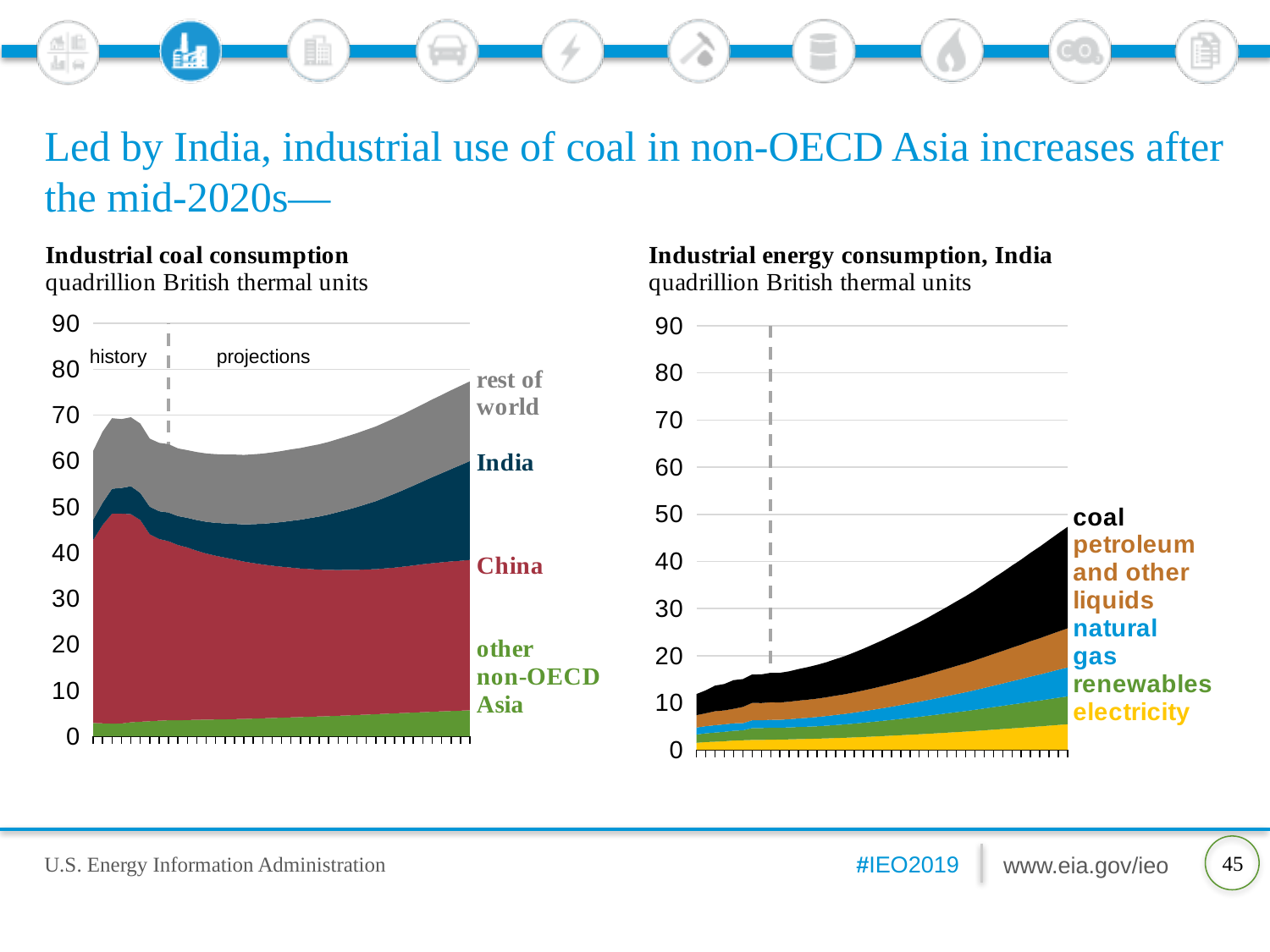
In the 'Industrial energy consumption, India' chart, does total industrial energy consumption rise or fall over the projection period? rise How many series are shown in the 'Industrial coal consumption' chart? 4 In the 'Industrial energy consumption, India' chart, is the total at the start of the history period greater or less than 20? less Which series in the 'Industrial energy consumption, India' chart is shown in yellow? electricity What unit is used on the y axis of the 'Industrial coal consumption' chart? quadrillion British thermal units In the 'Industrial energy consumption, India' chart, is the total at the end of the projection period greater or less than 40? greater What kind of chart is the 'Industrial coal consumption' chart? stacked area chart In the 'Industrial energy consumption, India' chart, is the total at the end of the projection period greater or less than 50? less How many series are shown in the 'Industrial energy consumption, India' chart? 5 In the 'Industrial energy consumption, India' chart, which fuel accounts for the largest share at the end of the projection period? coal In the 'Industrial coal consumption' chart, which region has the largest share of coal consumption at the end of the projection period, China or India? China